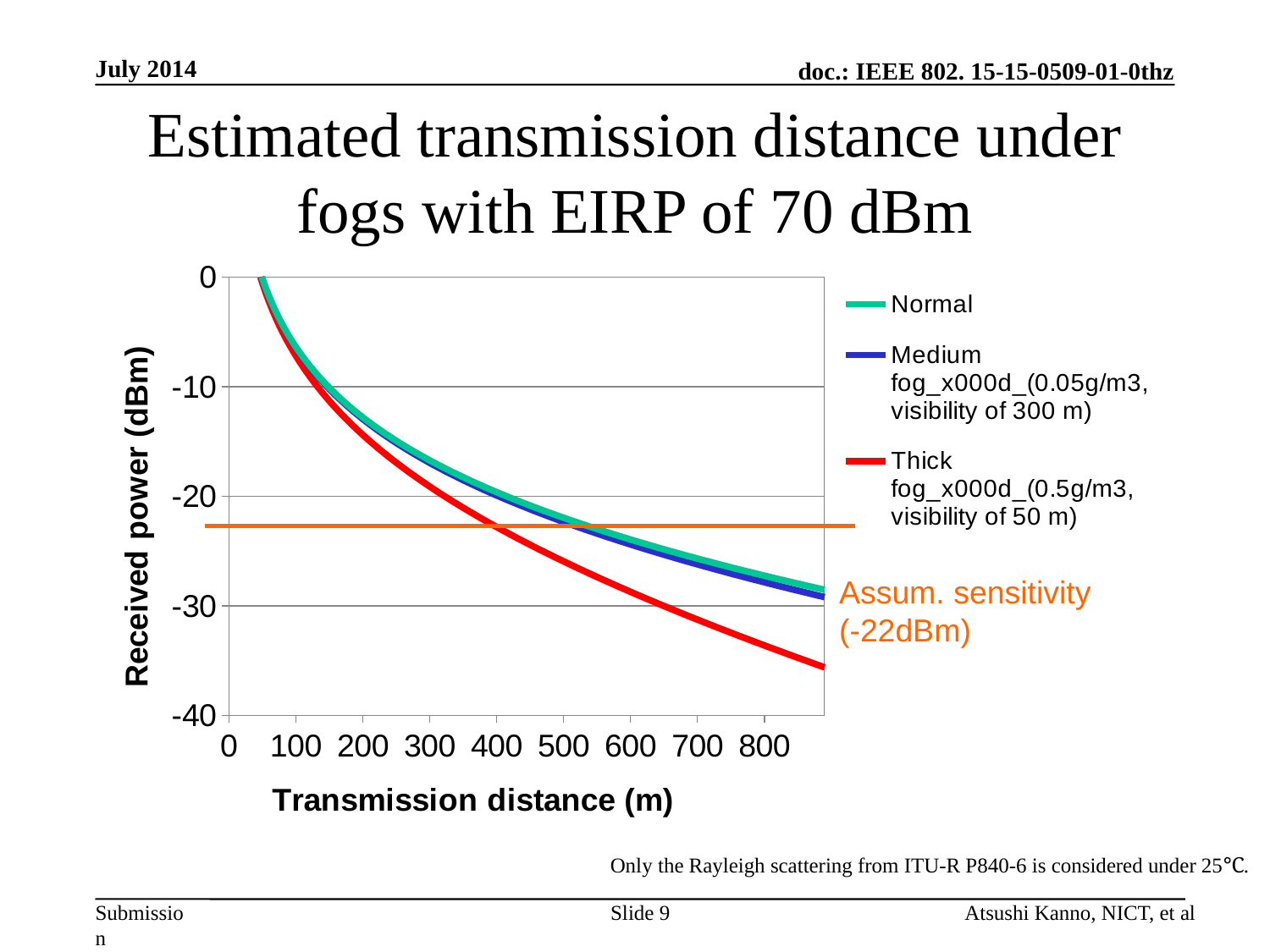
Which series has the lowest received power at 800 m? Thick fog Does the received power for the Thick fog series rise or fall as transmission distance increases? fall Is the received power for the Normal series at 200 m greater or less than -10 dBm? less At 800 m, which series has the higher received power: Normal or Thick fog? Normal How many series does the chart legend list? 3 Is the received power for the Thick fog series at 600 m greater or less than -20 dBm? less Is the received power for the Thick fog series at 800 m greater or less than -30 dBm? less What kind of chart is shown on the slide? line chart What is the title of the chart on the slide? Estimated transmission distance under fogs with EIRP of 70 dBm What is the label of the vertical axis? Received power (dBm)